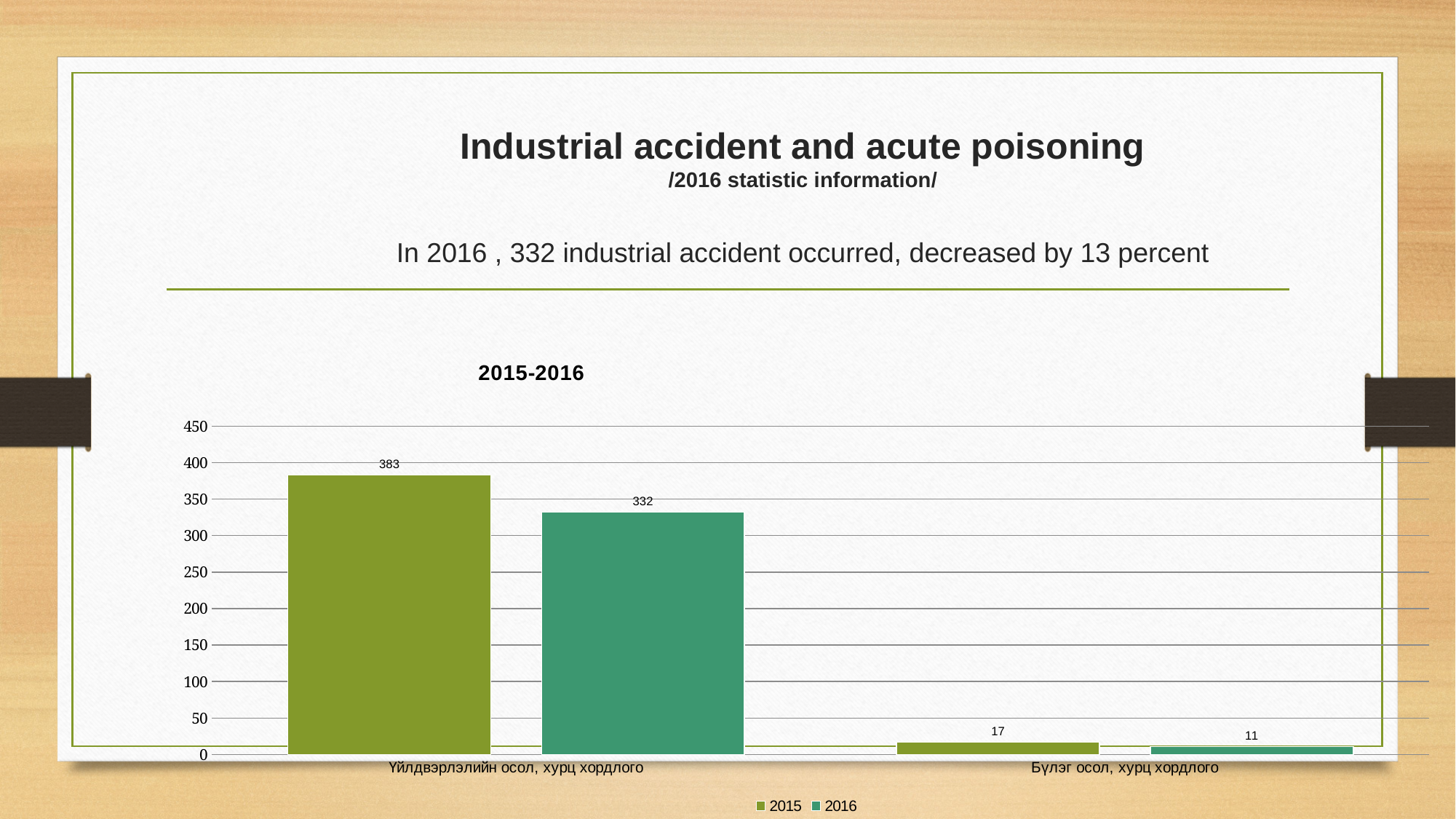
What is the difference between the 2015 and 2016 values for Бүлэг осол, хурц хордлого? 6 Which category has the lowest 2016 value? Бүлэг осол, хурц хордлого What is the difference between the 2015 and 2016 values for Үйлдвэрлэлийн осол, хурц хордлого? 51 How many categories are shown on the x axis? 2 What is the 2016 value for Бүлэг осол, хурц хордлого? 11 Which is larger for Үйлдвэрлэлийн осол, хурц хордлого: the 2015 value or the 2016 value? 2015 What is the 2016 value for Үйлдвэрлэлийн осол, хурц хордлого? 332 What is the 2015 value for Бүлэг осол, хурц хордлого? 17 How many series does the legend list? 2 Which category has the highest 2015 value? Үйлдвэрлэлийн осол, хурц хордлого What is the 2015 value for Үйлдвэрлэлийн осол, хурц хордлого? 383 What kind of chart is shown on the slide? Bar chart